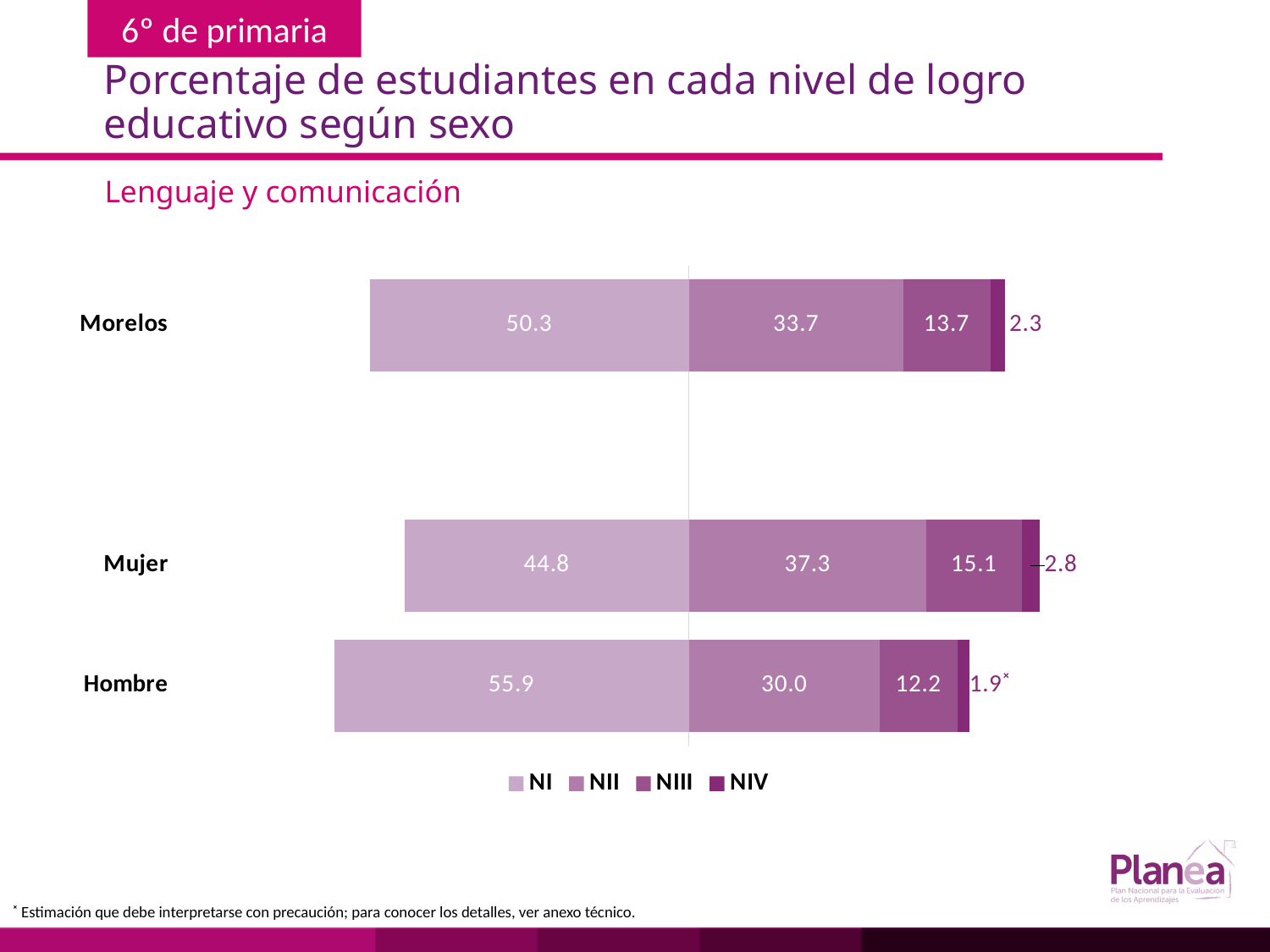
What is the total of the stacked bar for Mujer? 100.0 What kind of chart is shown on the slide? Stacked bar chart What is the NIV value for Morelos? 2.3 Which category has the lowest NIV value? Hombre How many categories are shown on the chart? 3 How many series does the legend list? 4 What is the NIII value for Hombre? 12.2 Which is larger, the NIII value for Mujer or the NIII value for Morelos? Mujer Which category has the highest NI value? Hombre What percentage of Hombre students are at level NI? 55.9 What is the difference between the NI values for Hombre and Mujer? 11.1 What is the NII value for Mujer? 37.3